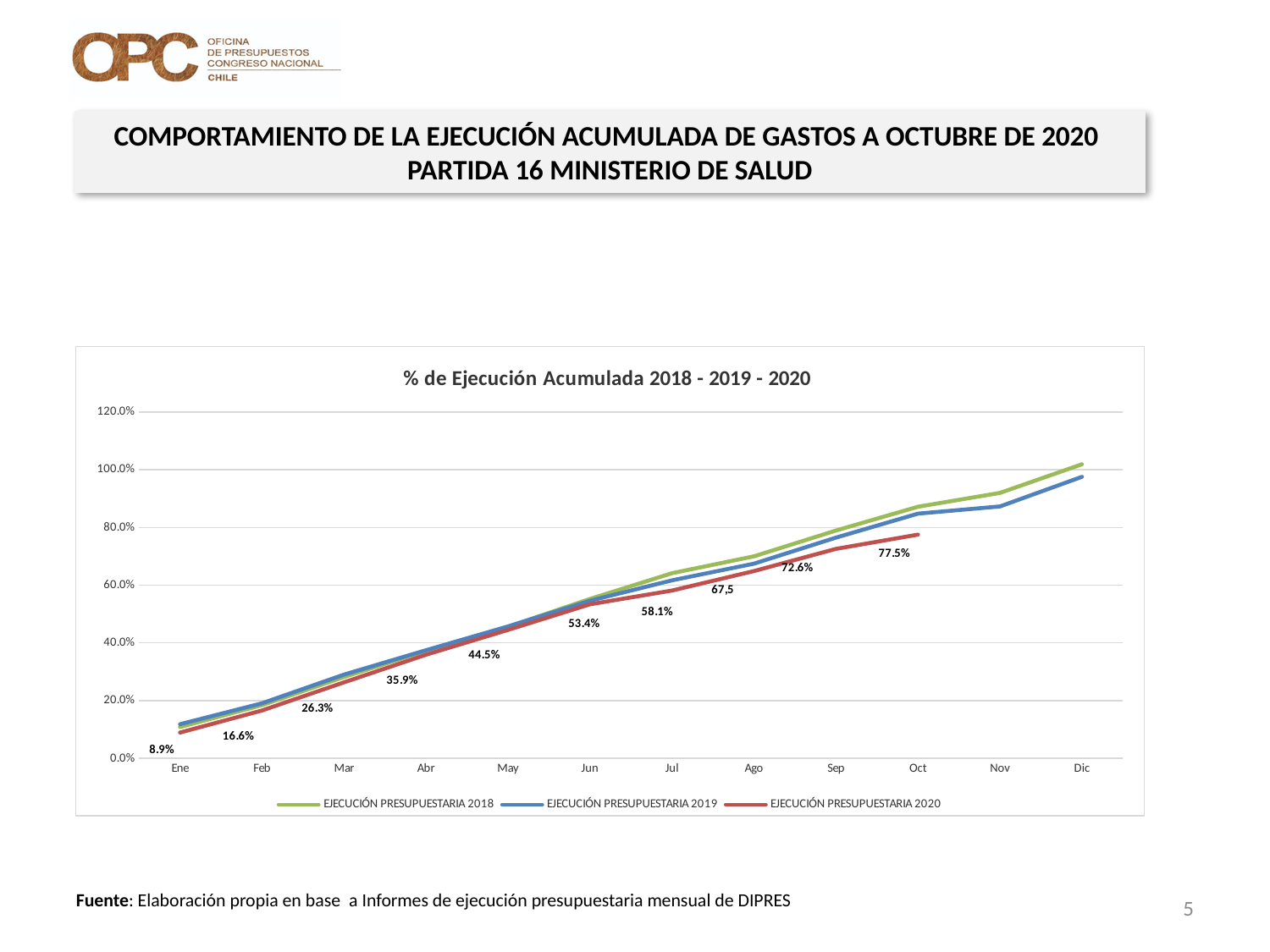
What is the title of the chart? % de Ejecución Acumulada 2018 - 2019 - 2020 What type of chart is shown on the slide? line chart What is the value labelled for EJECUCIÓN PRESUPUESTARIA 2020 in Abr? 35.9% Do the values for EJECUCIÓN PRESUPUESTARIA 2020 rise or fall from Ene to Oct? rise How many series does the legend list? 3 What is the value labelled for EJECUCIÓN PRESUPUESTARIA 2020 in Jun? 53.4% In Oct, which series is higher: EJECUCIÓN PRESUPUESTARIA 2018 or EJECUCIÓN PRESUPUESTARIA 2020? EJECUCIÓN PRESUPUESTARIA 2018 What is the value labelled for EJECUCIÓN PRESUPUESTARIA 2020 in Oct? 77.5% How many months are shown along the x axis? 12 What is the value labelled for EJECUCIÓN PRESUPUESTARIA 2020 in Ene? 8.9% Is the value for EJECUCIÓN PRESUPUESTARIA 2018 in Dic greater or less than 100.0%? greater What is the difference between the 2020 values for Oct (77.5%) and Sep (72.6%)? 4.9 percentage points